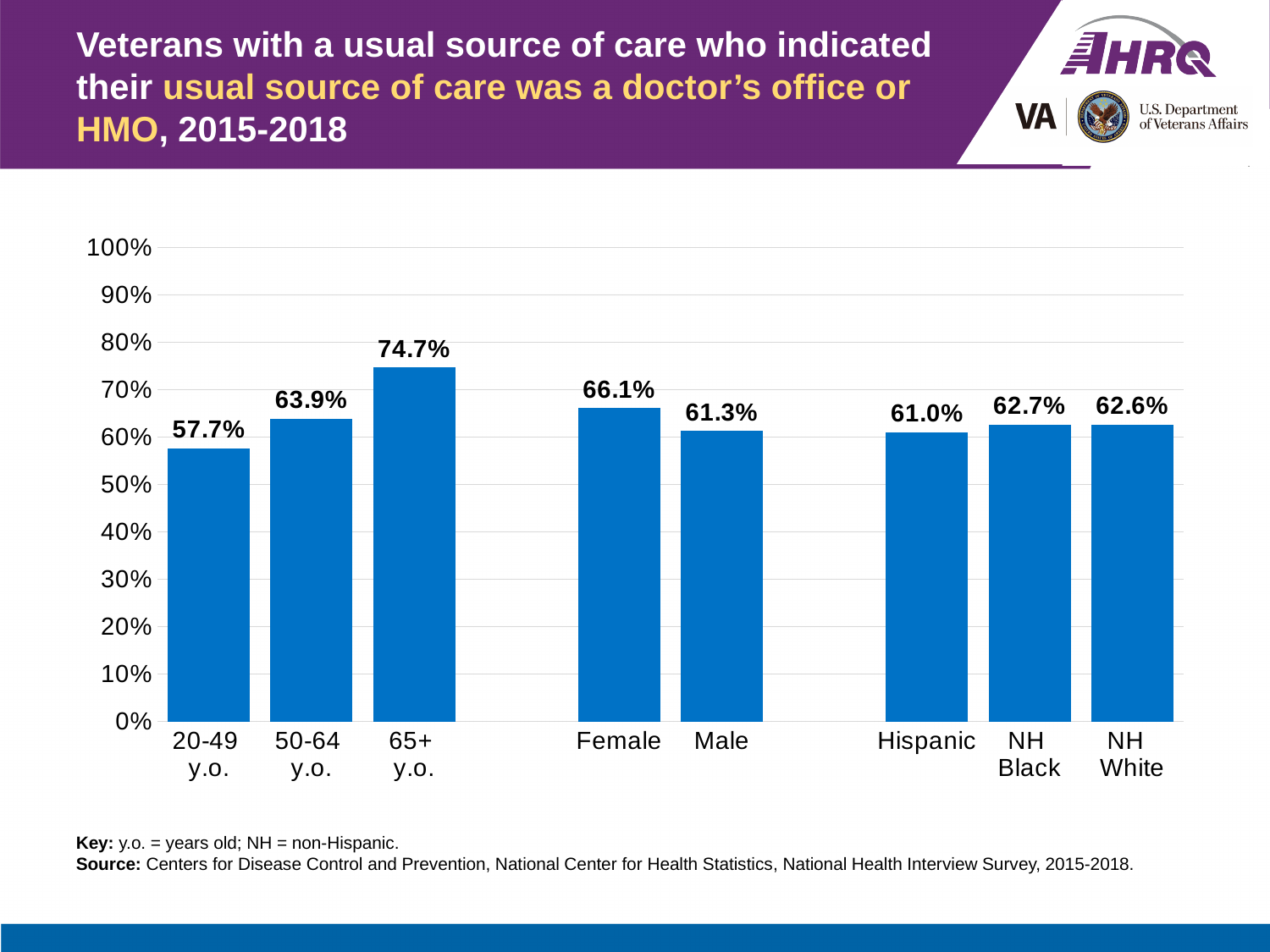
What is the difference between the values for Female and Male? 4.8% How many categories are shown on the chart? 8 What is the value for Hispanic veterans? 61.0% Which category has the highest value? 65+ y.o. What kind of chart is shown on the slide? Bar chart Which category has the lowest value? 20-49 y.o. Which is larger, the value for 50-64 y.o. or the value for Male? 50-64 y.o. What is the value for the 65+ y.o. group? 74.7% What is the difference between the values for 65+ y.o. and 20-49 y.o.? 17.0% Is the value for NH Black greater or less than 60%? greater Do the values rise or fall across the three age groups from 20-49 y.o. to 65+ y.o.? Rise What is the value for Female veterans? 66.1%